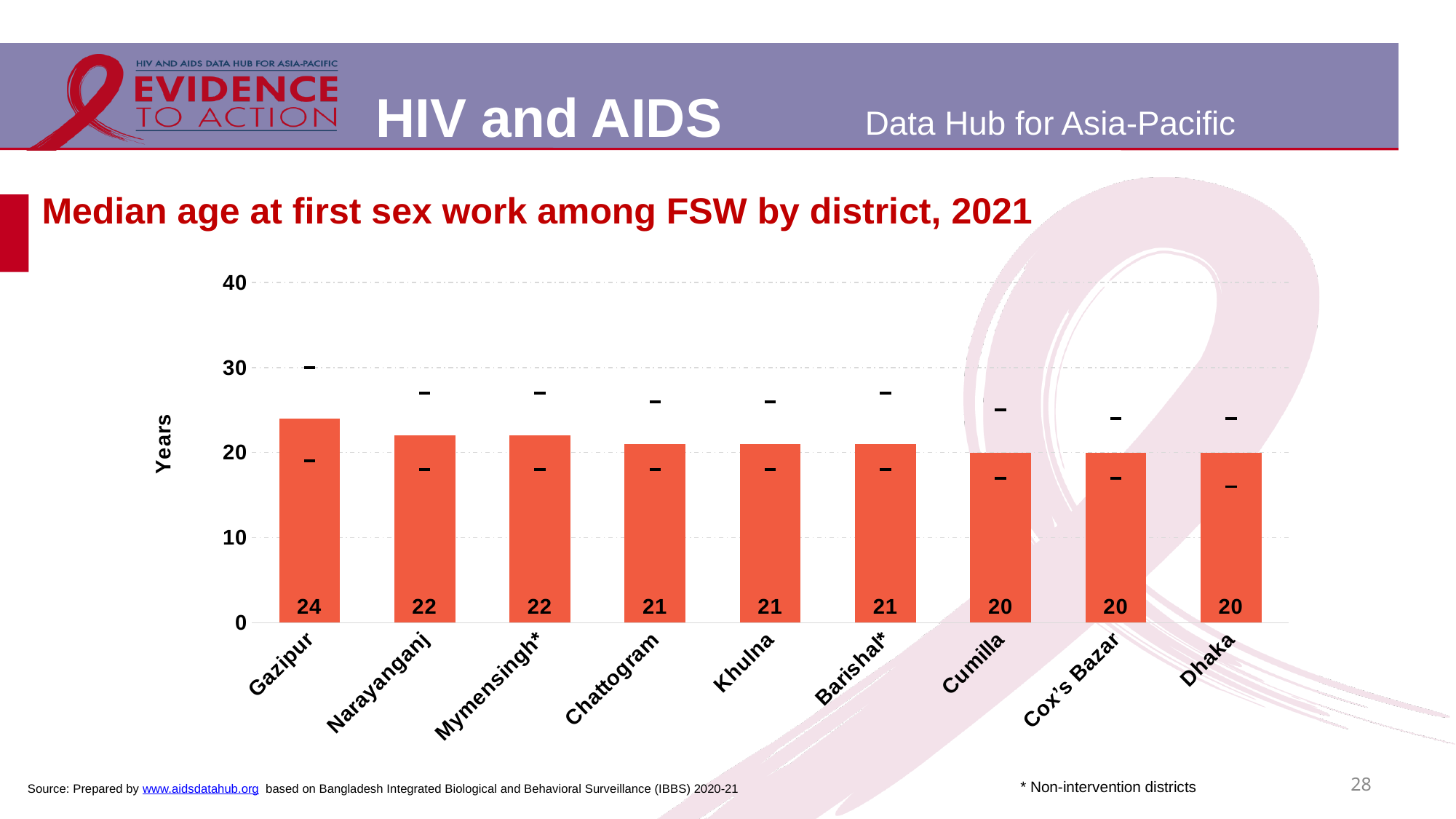
Which district has the highest median age at first sex work? Gazipur What is the median age at first sex work among FSW in Dhaka? 20 Which is larger, the median age in Mymensingh* or in Khulna? Mymensingh* What is the median age at first sex work among FSW in Chattogram? 21 What is the median age at first sex work among FSW in Narayanganj? 22 Do the bar values rise or fall from left to right across the districts? fall What is the label on the vertical axis of the chart? Years What is the median age at first sex work among FSW in Gazipur? 24 How many districts are shown in the chart? 9 What is the difference between the median age in Gazipur and in Cumilla? 4 Is the value for Gazipur greater or less than 30? less What kind of chart is shown on the slide? bar chart